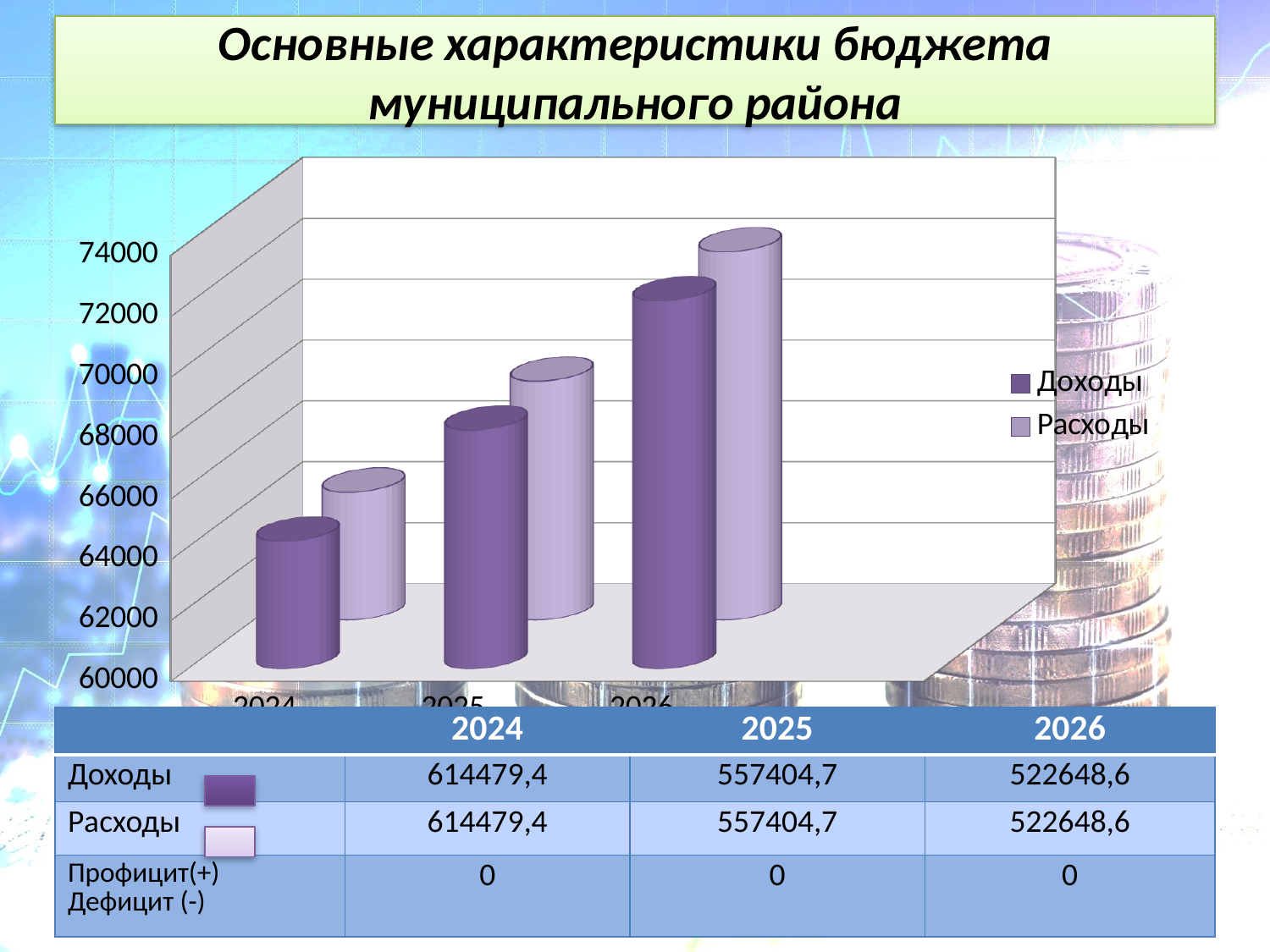
On the chart, is the Доходы bar for 2026 greater or less than 70000? greater What is the title of the slide containing the chart? Основные характеристики бюджета муниципального района How many years (categories) are plotted on the chart's x axis? 3 On the chart, is the Доходы bar for 2024 greater or less than 66000? less Which series are listed in the chart legend? Доходы, Расходы Do the Доходы bars rise or fall from 2024 to 2026 on the chart? rise How many series does the chart legend list? 2 What kind of chart is shown on the slide? bar chart Which year has the tallest Расходы bar on the chart? 2026 Which year has the shortest Доходы bar on the chart? 2024 On the chart, which is taller for 2025: the Доходы bar or the Расходы bar? Neither; they are equal